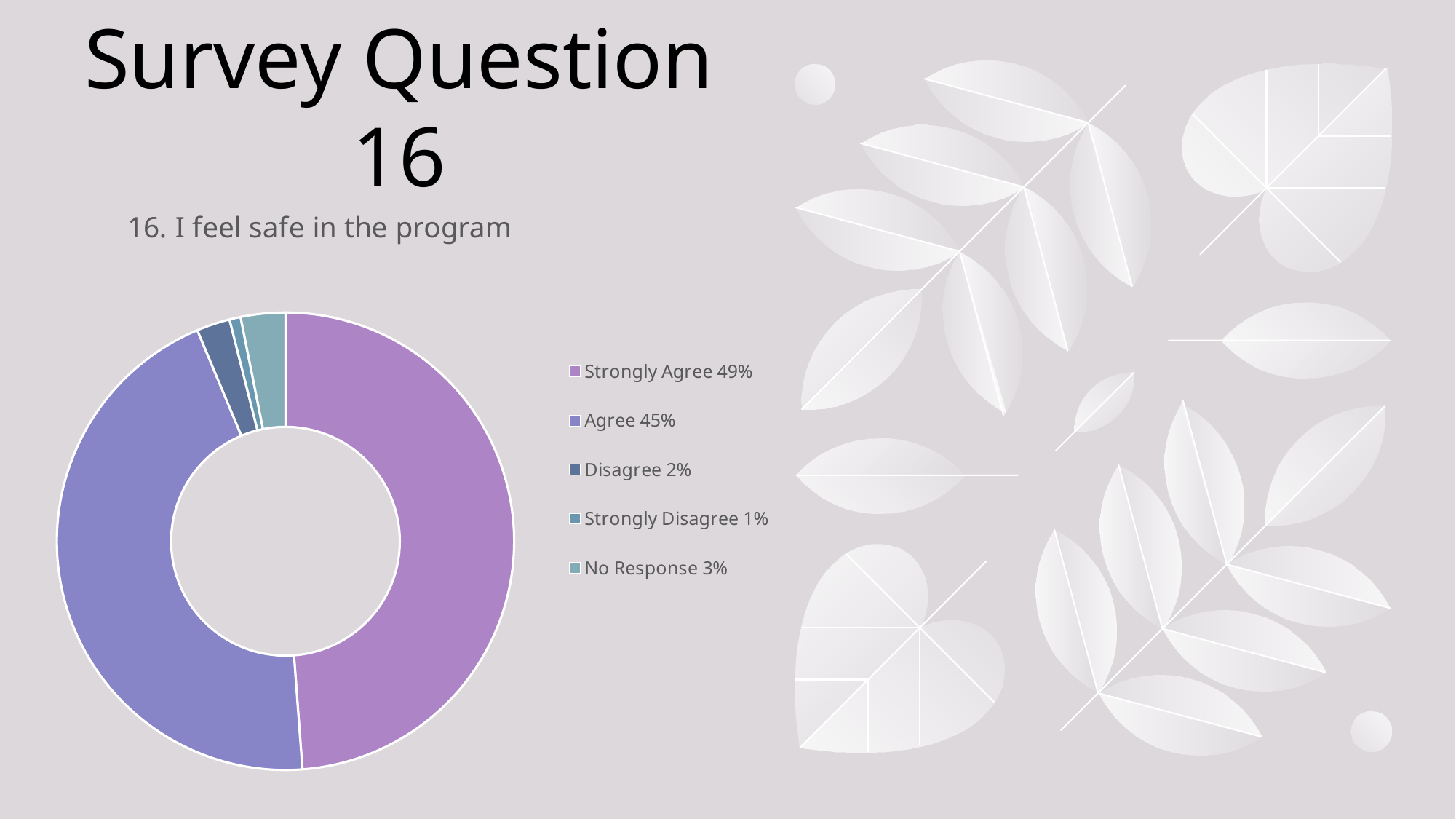
What is the difference in percentage points between Strongly Agree and Agree? 4 What kind of chart is shown on the slide? Doughnut chart What percentage of respondents gave No Response? 3% How many response categories does the legend list? 5 What percentage of respondents answered Strongly Agree? 49% Which is larger, the share for No Response or the share for Disagree? No Response What percentage of respondents answered Agree? 45% What is the combined percentage of Strongly Agree and Agree responses? 94% Which response category has the largest share of the chart? Strongly Agree What percentage of respondents answered Disagree? 2% Which response category has the smallest share of the chart? Strongly Disagree What survey statement does the chart relate to? I feel safe in the program